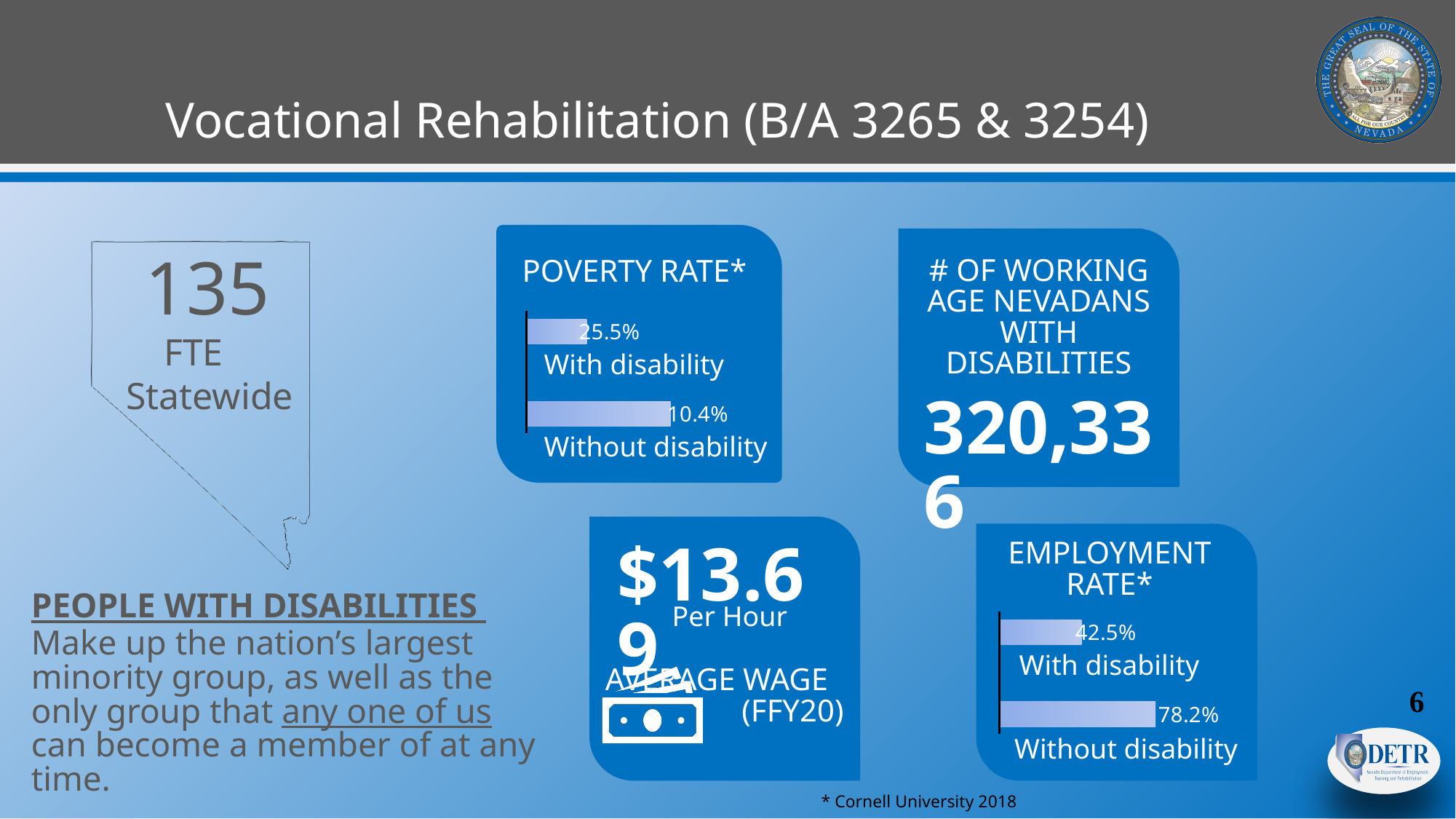
In the Poverty Rate chart, what is the poverty rate for people with disability? 25.5% In the Employment Rate chart, is the value for without disability larger than the value for with disability? Yes In the Poverty Rate chart, which category has the higher poverty rate? With disability In the Poverty Rate chart, what is the poverty rate for people without disability? 10.4% What kind of chart is the Employment Rate chart? Bar chart In the Employment Rate chart, what is the employment rate for people without disability? 78.2% How many categories are shown in the Poverty Rate chart? 2 What is the title of the chart in the upper middle of the slide? POVERTY RATE* In the Employment Rate chart, what is the employment rate for people with disability? 42.5% In the Poverty Rate chart, what is the difference between the poverty rate with disability and without disability? 15.1% In the Employment Rate chart, what is the difference between the employment rate without disability and with disability? 35.7% In the Employment Rate chart, which category has the lower employment rate? With disability